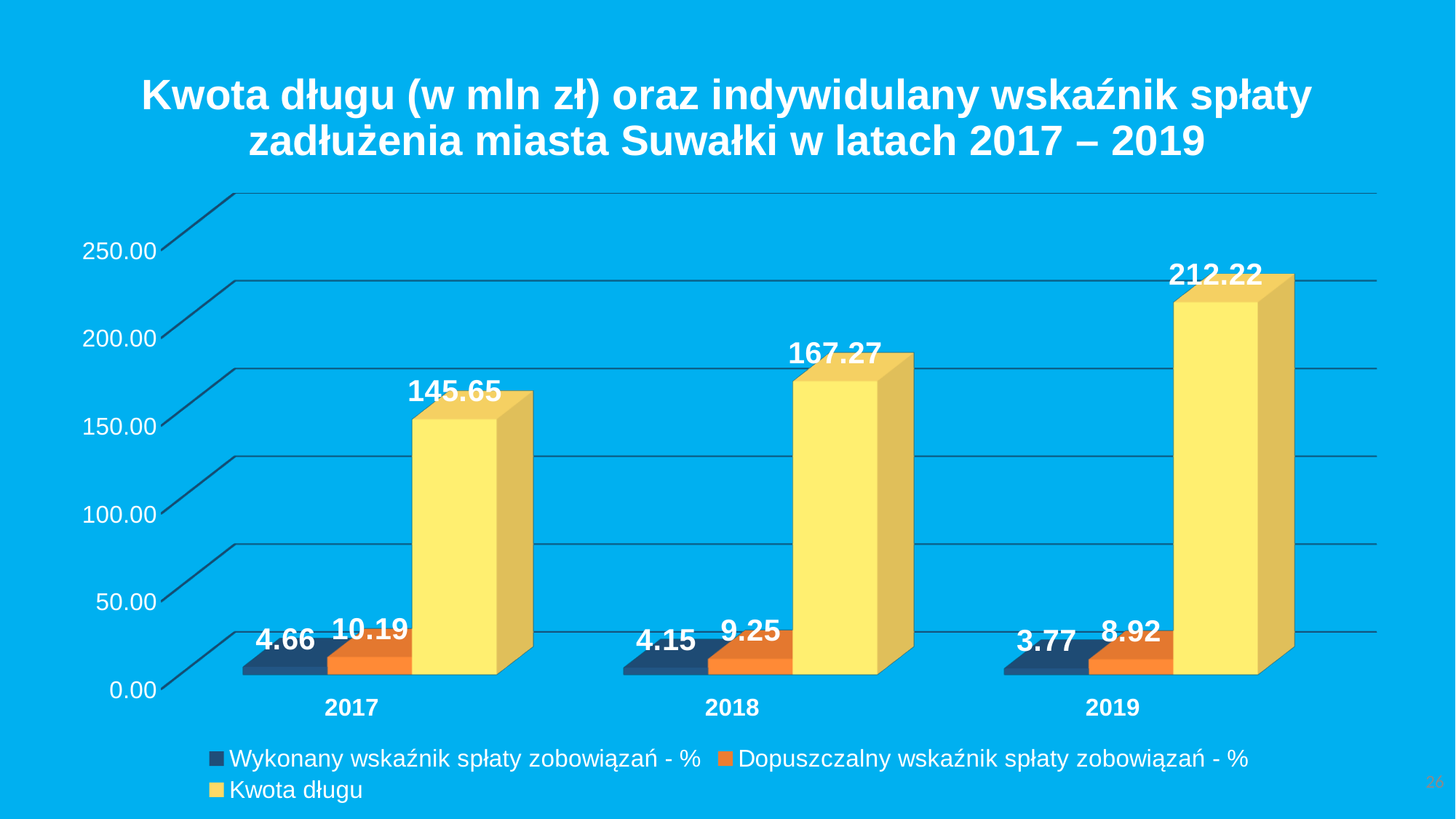
Does Kwota długu rise or fall from 2017 to 2019? rise How many series does the legend list? 3 What is the value of Wykonany wskaźnik spłaty zobowiązań - % for 2017? 4.66 Is the value of Kwota długu for 2018 greater or less than 150.00? greater What is the difference between Kwota długu in 2019 and in 2018? 44.95 How many years are shown on the x axis? 3 What kind of chart is shown on the slide? bar chart Which is larger: Dopuszczalny wskaźnik spłaty zobowiązań - % in 2017 or in 2019? 2017 What is the value of Dopuszczalny wskaźnik spłaty zobowiązań - % for 2018? 9.25 In which year is Kwota długu highest? 2019 What is the value of Kwota długu for 2019? 212.22 In which year is Wykonany wskaźnik spłaty zobowiązań - % lowest? 2019